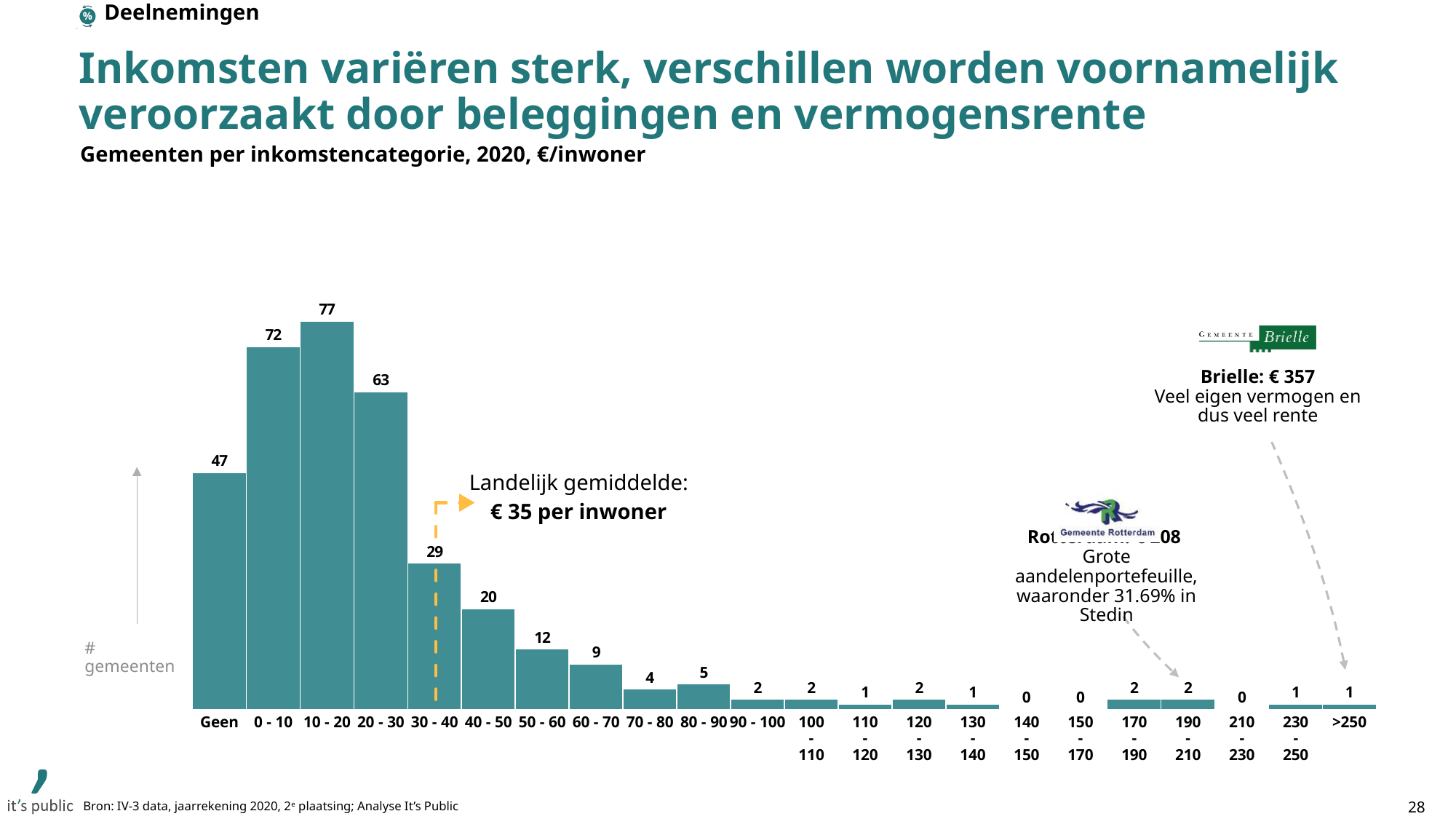
How many gemeenten are in the '10 - 20' income category? 77 Which is larger, the value for '70 - 80' or the value for '80 - 90'? 80 - 90 Which income category has the highest number of gemeenten? 10 - 20 How many income categories are shown on the x axis? 22 What is the difference between the '0 - 10' and '20 - 30' categories? 9 What is the subtitle of the chart? Gemeenten per inkomstencategorie, 2020, €/inwoner What kind of chart is shown on the slide? Bar chart What is the national average (landelijk gemiddelde) annotated on the chart? € 35 per inwoner Do the values rise or fall from the '10 - 20' category to the '90 - 100' category? Fall What is the value shown for the 'Geen' category? 47 What is the value shown for the '>250' category? 1 How many gemeenten fall in the '30 - 40' category? 29